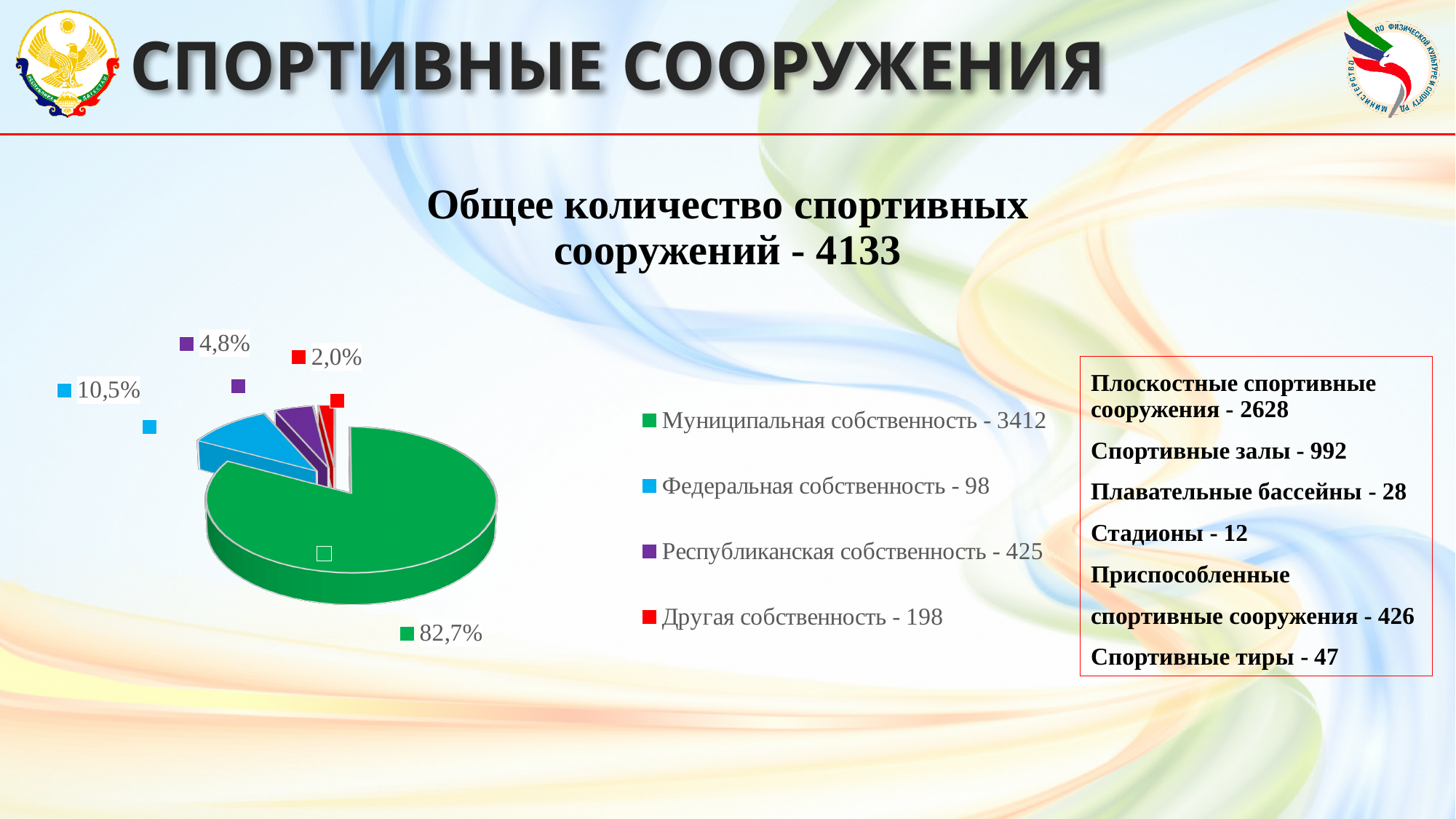
What percentage label is shown on the red slice of the pie chart? 2,0% How many entries does the legend of the pie chart list? 4 How many slices does the pie chart have? 4 What value is given in the legend for Другая собственность? 198 What percentage label is shown on the green slice of the pie chart? 82,7% What value is given in the legend for Муниципальная собственность? 3412 Which legend category has the largest value in the pie chart? Муниципальная собственность What value is given in the legend for Республиканская собственность? 425 What kind of chart is shown on the slide? pie chart What is the difference between the legend values for Республиканская собственность and Другая собственность? 227 What value is given in the legend for Федеральная собственность? 98 Which legend category has the smallest value in the pie chart? Федеральная собственность